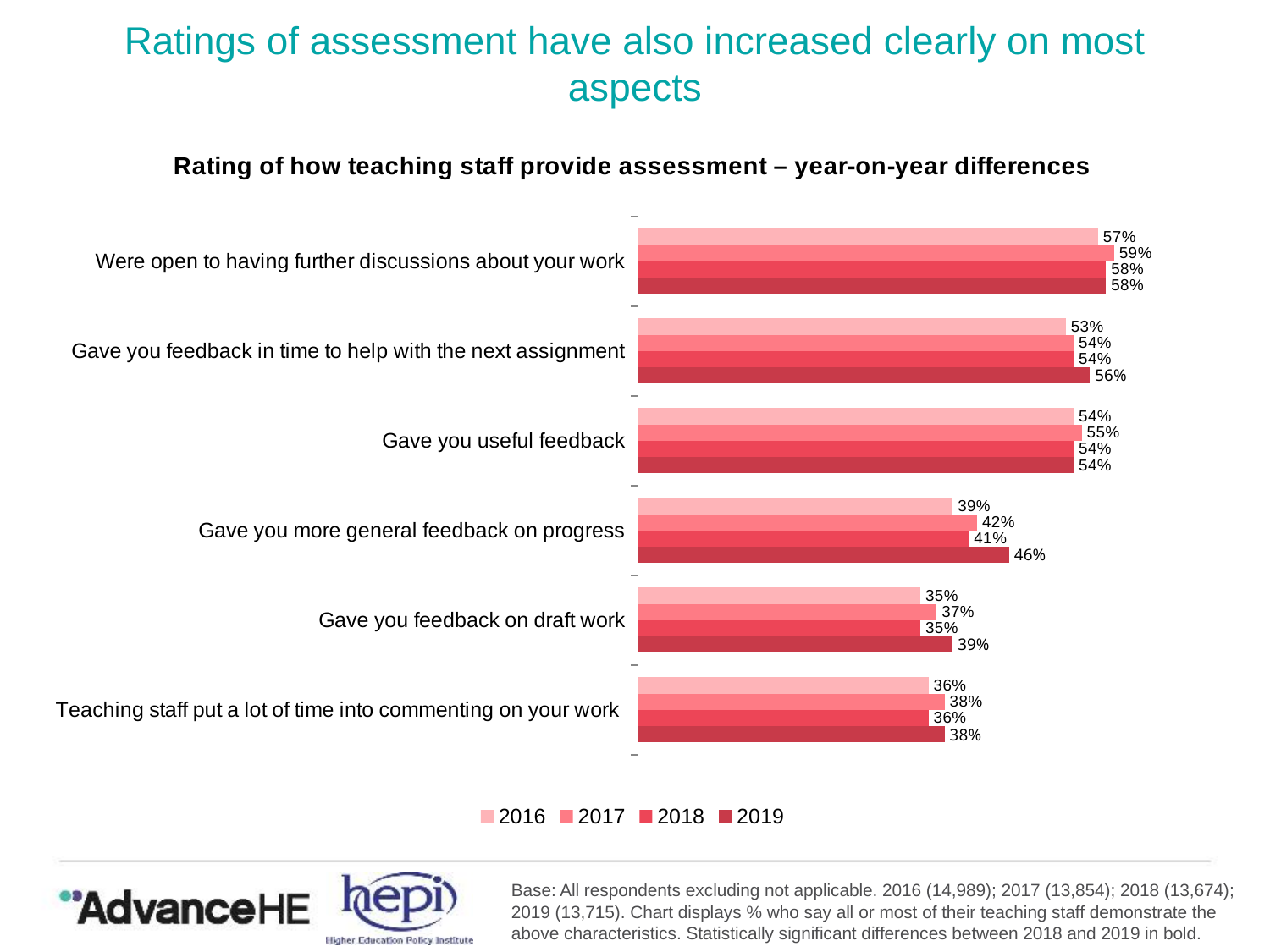
What is the difference between the 2019 and 2016 values for 'Gave you feedback on draft work'? 4% What is the 2016 value for 'Were open to having further discussions about your work'? 57% How many categories (aspects of assessment) are shown in the chart? 6 What kind of chart is shown on the slide? bar chart What is the 2017 value for 'Gave you feedback on draft work'? 37% What is the difference between the 2019 and 2018 values for 'Gave you more general feedback on progress'? 5% Which is larger for 'Gave you feedback in time to help with the next assignment': the 2016 value or the 2019 value? 2019 How many series does the legend list? 4 Which category has the lowest 2016 value? Gave you feedback on draft work What is the 2019 value for 'Gave you more general feedback on progress'? 46% What is the title of the chart? Rating of how teaching staff provide assessment – year-on-year differences Which category has the highest 2017 value? Were open to having further discussions about your work